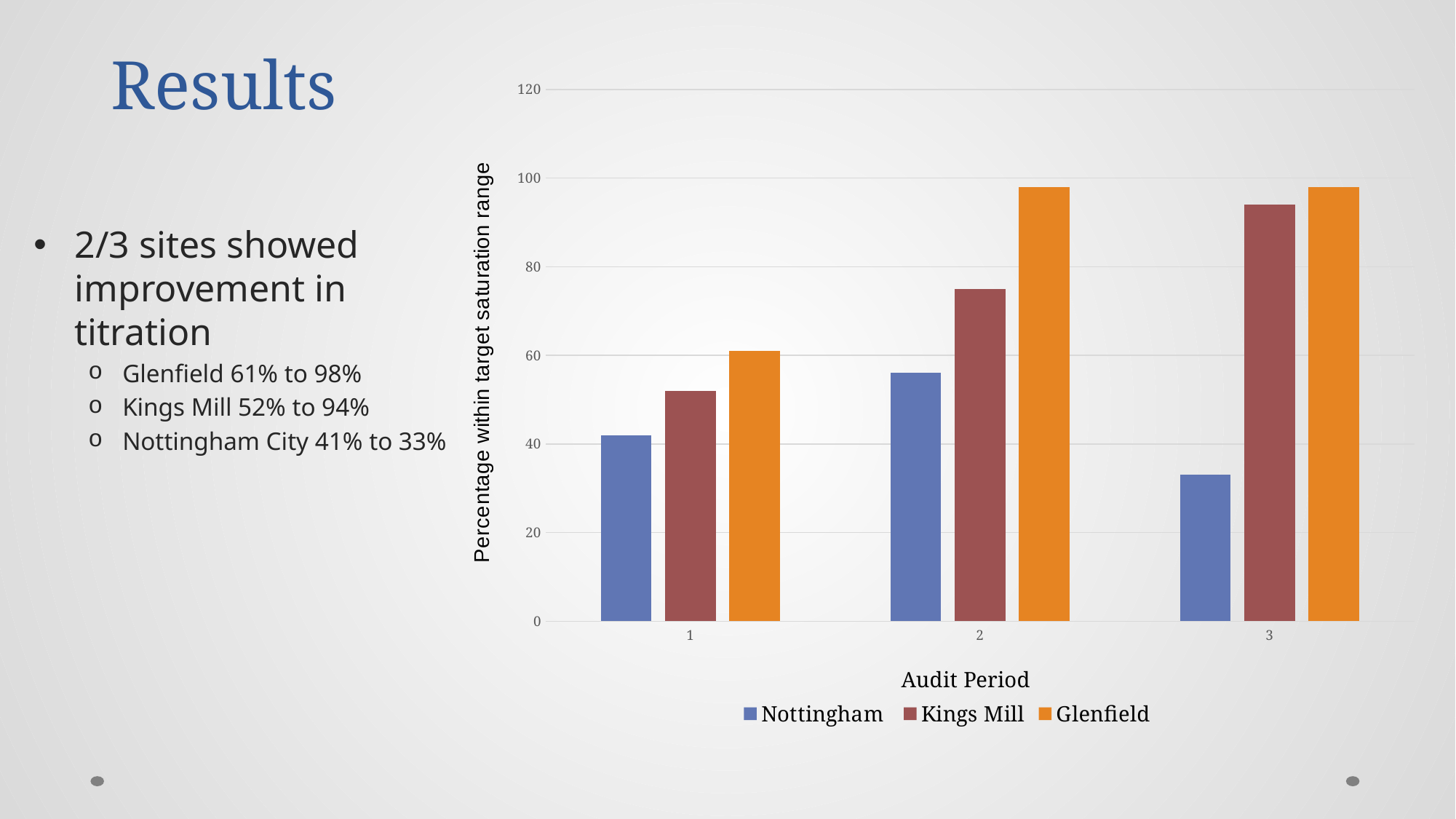
Is the value for Nottingham in audit period 2 greater or less than 60? less What kind of chart is shown on the slide? bar chart Does the Nottingham series rise or fall from audit period 2 to audit period 3? fall Is the value for Kings Mill in audit period 2 greater or less than 60? greater What is the label of the chart's x axis? Audit Period Which series has the highest value in audit period 3? Glenfield How many audit periods are shown on the x axis of the chart? 3 Which series has the lowest value in audit period 3? Nottingham What is the label of the chart's y axis? Percentage within target saturation range Is the Glenfield bar in audit period 2 larger or smaller than the Kings Mill bar in audit period 2? larger How many series does the chart legend list? 3 Which series has the lowest value in audit period 1? Nottingham